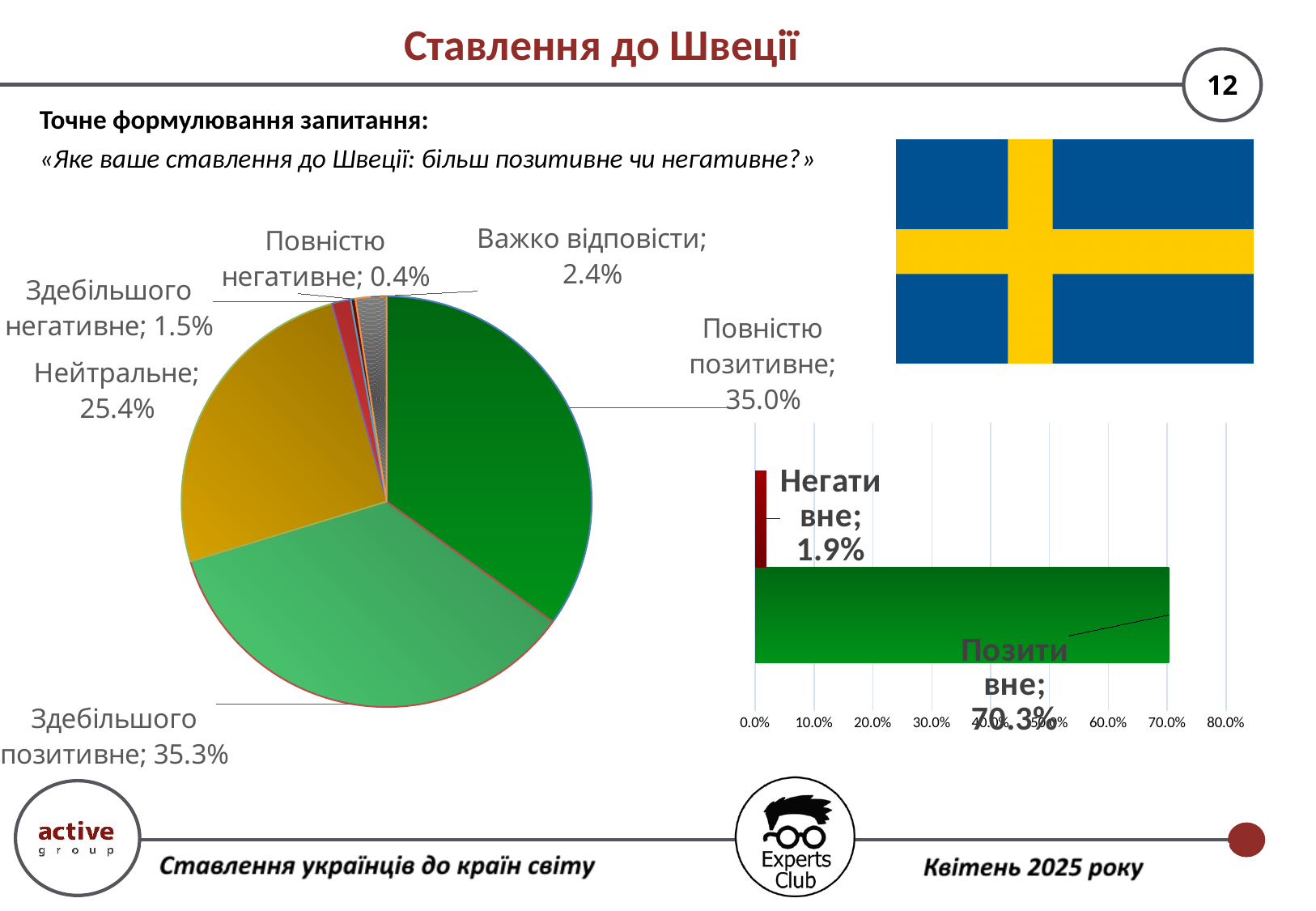
In the pie chart, which is larger: "Нейтральне" or "Важко відповісти"? Нейтральне In the bar chart on the right, what is the difference between "Позитивне" and "Негативне"? 68.4% In the pie chart, what share of respondents answered "Нейтральне"? 25.4% In the bar chart on the right, what is the value for "Позитивне"? 70.3% In the pie chart, which category has the smallest share? Повністю негативне In the bar chart on the right, which category has the highest value? Позитивне In the pie chart, what is the difference between "Здебільшого негативне" and "Повністю негативне"? 1.1% How many categories does the pie chart show? 6 What type of chart is shown on the right side of the slide? Bar chart In the bar chart on the right, what is the value for "Негативне"? 1.9% In the pie chart, what is the value for "Важко відповісти"? 2.4% In the pie chart, what is the value for "Повністю позитивне"? 35.0%